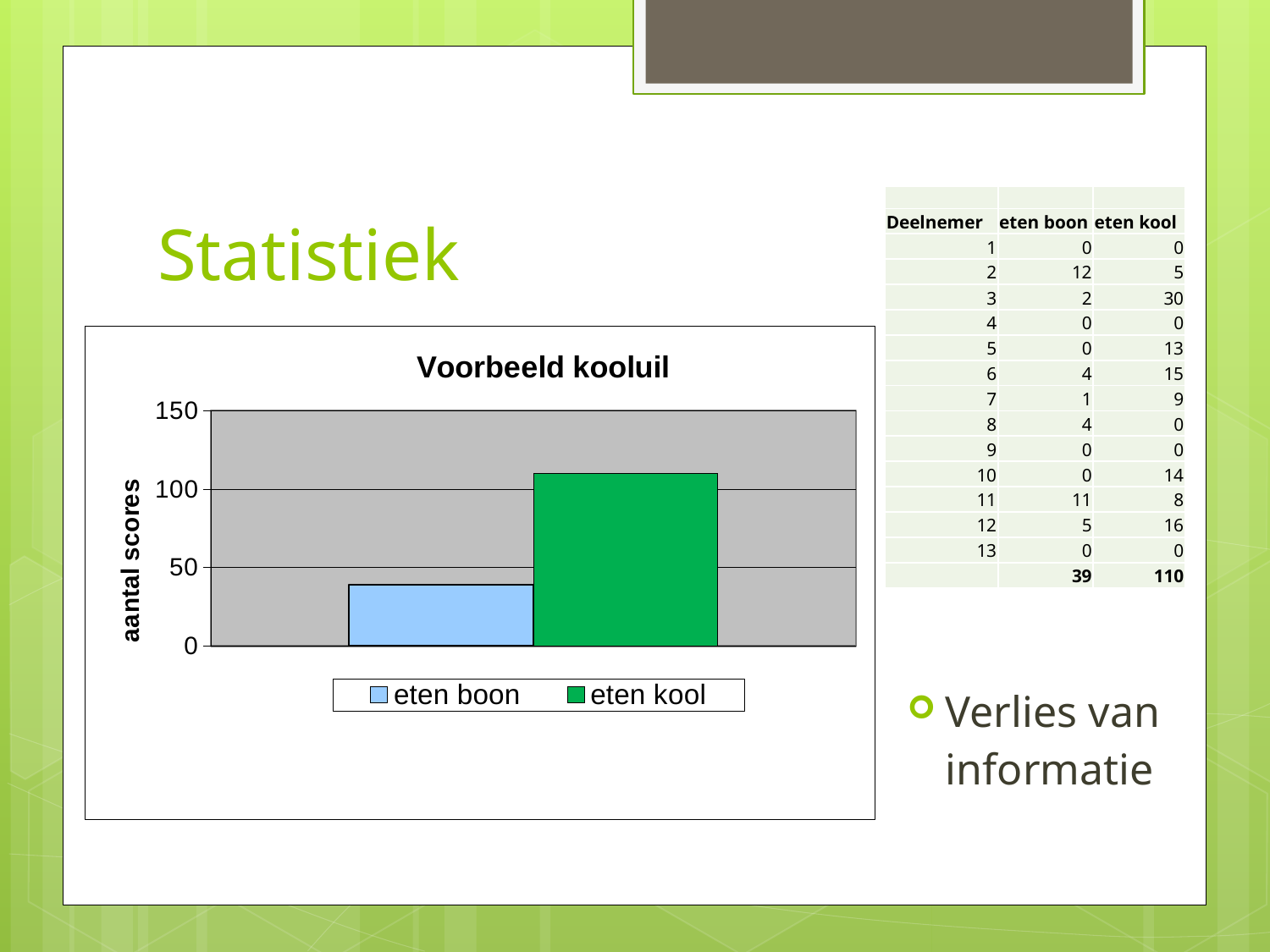
Is the value for eten kool greater or less than 100? greater How many series does the chart legend list? 2 What are the two entries in the chart legend? eten boon, eten kool What is the highest tick value shown on the y axis of the chart? 150 Is the value for eten kool greater or less than 150? less Which series has the taller bar, eten boon or eten kool? eten kool What kind of chart is shown on the slide? bar chart Is the value for eten boon greater or less than 50? less Which series has the highest value in the chart? eten kool How many bars are plotted in the chart? 2 Which series has the lowest value in the chart? eten boon What is the title of the chart? Voorbeeld kooluil